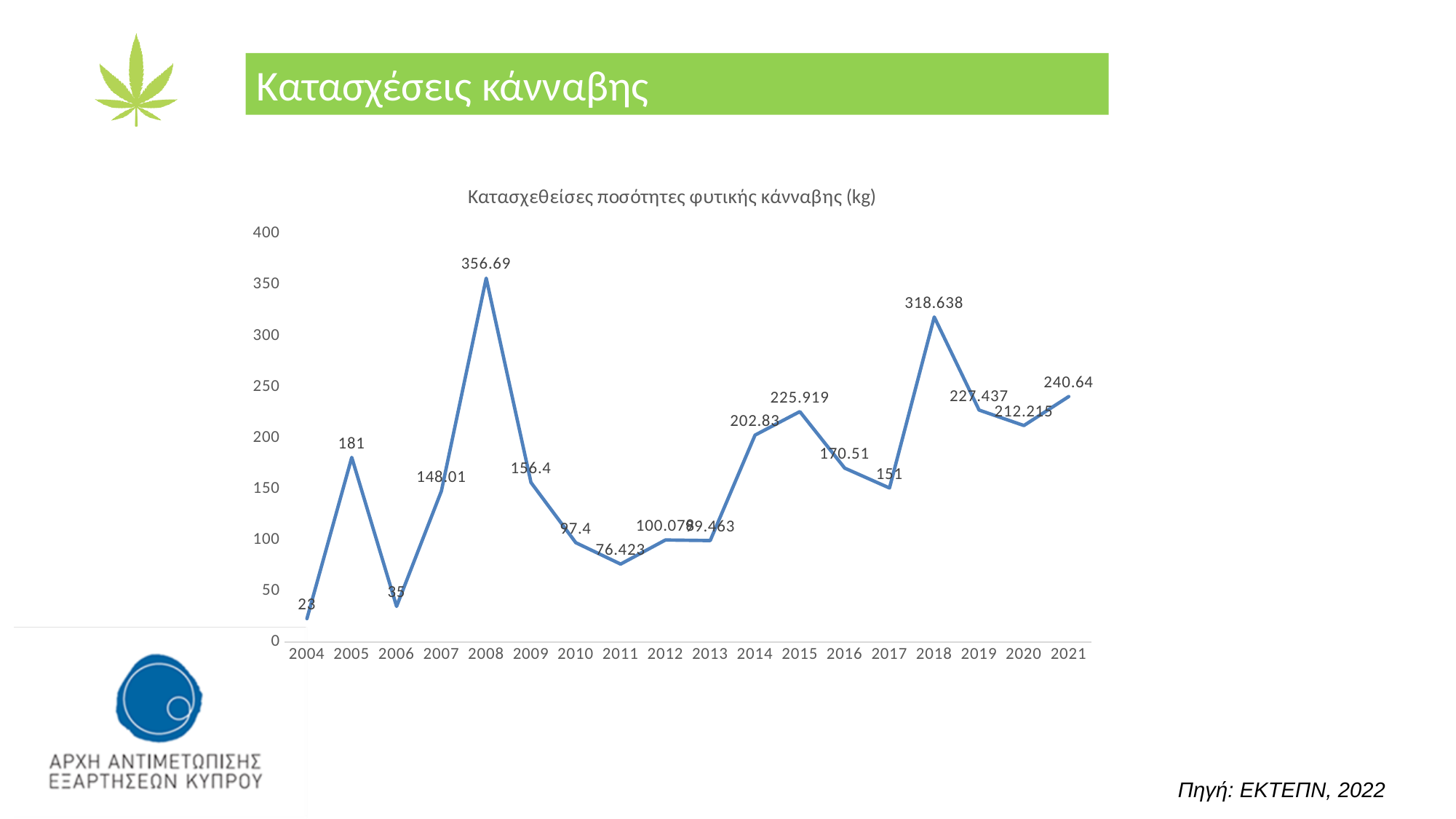
What is the seized quantity of herbal cannabis (kg) for 2004? 23 Which year has the highest seized quantity of herbal cannabis? 2008 What is the seized quantity of herbal cannabis (kg) for 2021? 240.64 What is the seized quantity of herbal cannabis (kg) for 2008? 356.69 What is the difference between the seized quantities in 2005 and 2006? 146 What is the seized quantity of herbal cannabis (kg) for 2018? 318.638 What type of chart is shown on the slide? line chart Is the value for 2011 greater or less than 100? less Which year has the lowest seized quantity of herbal cannabis? 2004 What is the title of the chart? Κατασχεθείσες ποσότητες φυτικής κάνναβης (kg) How many years are plotted on the x axis? 18 Which year had a larger seized quantity, 2015 or 2016? 2015